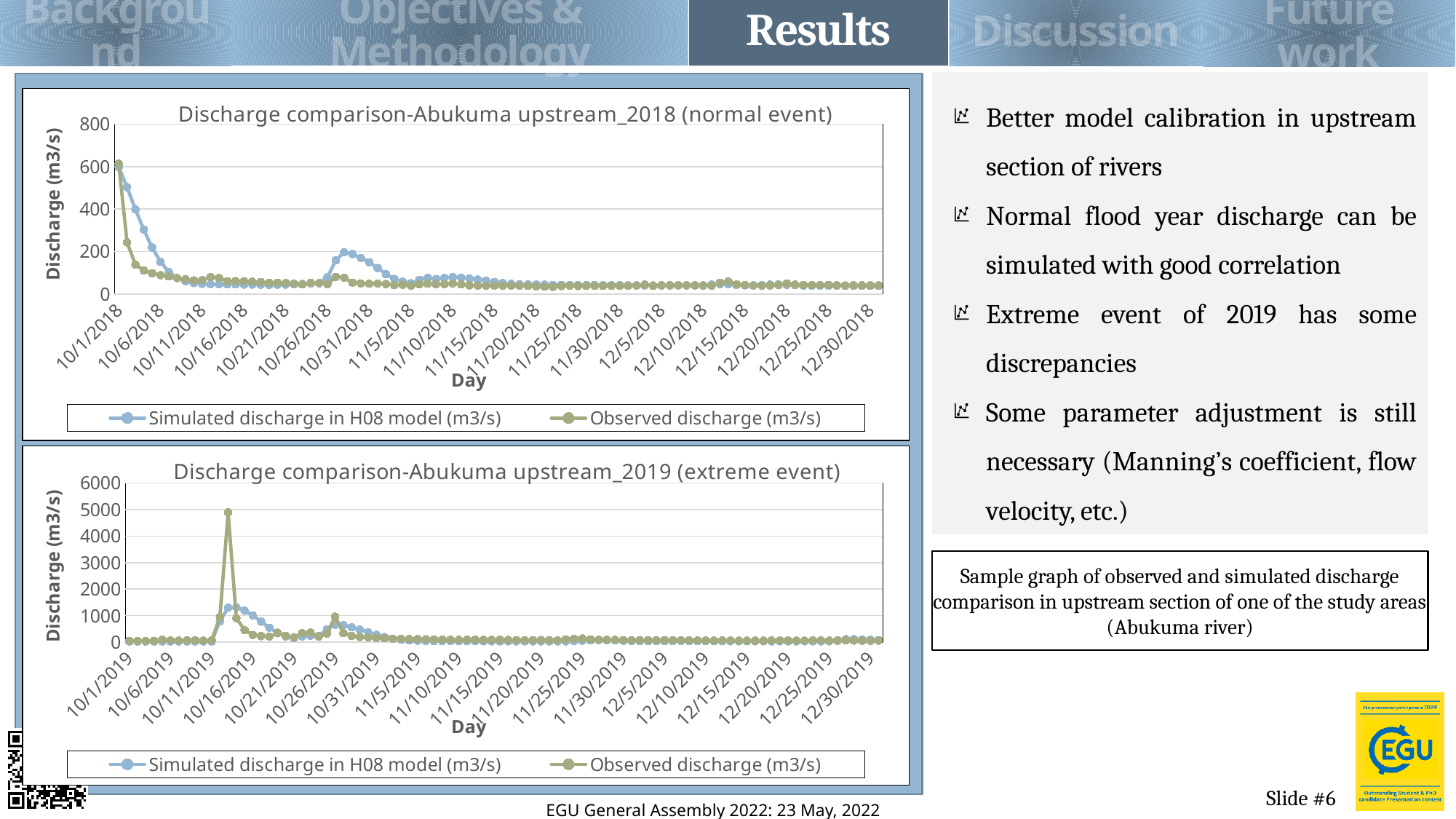
In the top chart (2018 normal event), is the Observed discharge value around 10/31/2018 greater or less than 200? less In the top chart (2018 normal event), what is the label of the y axis? Discharge (m3/s) In the bottom chart (2019 extreme event), what are the two legend entries? Simulated discharge in H08 model (m3/s) and Observed discharge (m3/s) What kind of chart is the top chart, 'Discharge comparison-Abukuma upstream_2018 (normal event)'? line chart In the top chart (2018 normal event), do the Simulated discharge values rise or fall from 10/1/2018 to 10/11/2018? fall In the top chart (2018 normal event), which series is higher around 10/31/2018, Simulated discharge in H08 model or Observed discharge? Simulated discharge in H08 model In the top chart (2018 normal event), is the Simulated discharge in H08 model value on 10/1/2018 greater or less than 400? greater How many series does the legend of the bottom chart, 'Discharge comparison-Abukuma upstream_2019 (extreme event)', list? 2 In the bottom chart (2019 extreme event), is the peak value of the Observed discharge greater or less than 4000? greater In the bottom chart (2019 extreme event), which series reaches the higher peak, Simulated discharge in H08 model or Observed discharge? Observed discharge